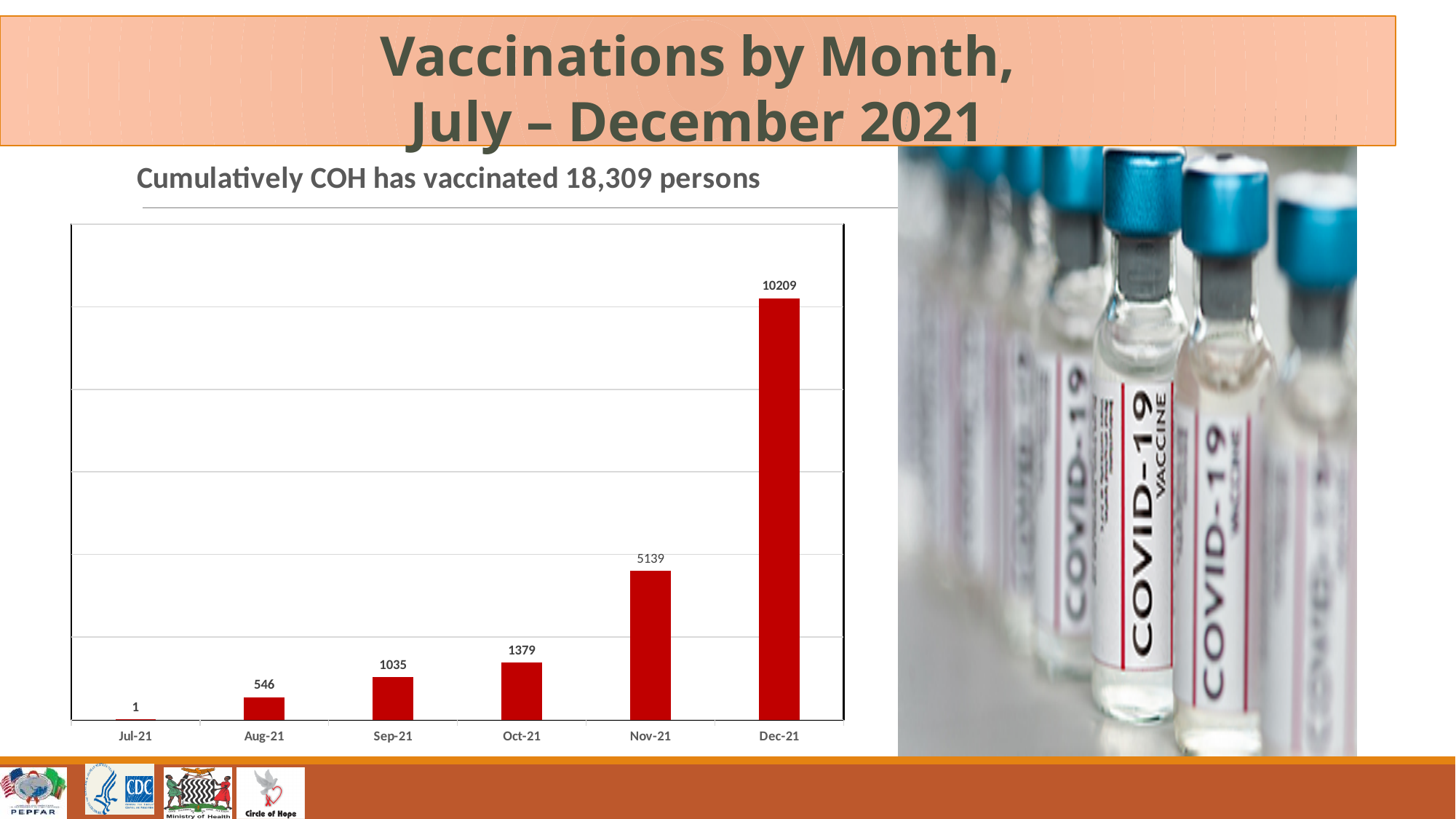
What is the number of vaccinations shown for Jul-21? 1 Which month has the lowest number of vaccinations? Jul-21 How many months are shown on the x axis of the chart? 6 Which month has the highest number of vaccinations? Dec-21 What is the difference between the vaccinations in Dec-21 and Nov-21? 5070 What type of chart is used to show vaccinations by month? Bar chart What is the number of vaccinations shown for Sep-21? 1035 What is the difference between the vaccinations in Oct-21 and Sep-21? 344 What is the number of vaccinations shown for Dec-21? 10209 Do the vaccination numbers rise or fall from Jul-21 to Dec-21? Rise What is the number of vaccinations shown for Nov-21? 5139 Which month has more vaccinations, Aug-21 or Oct-21? Oct-21